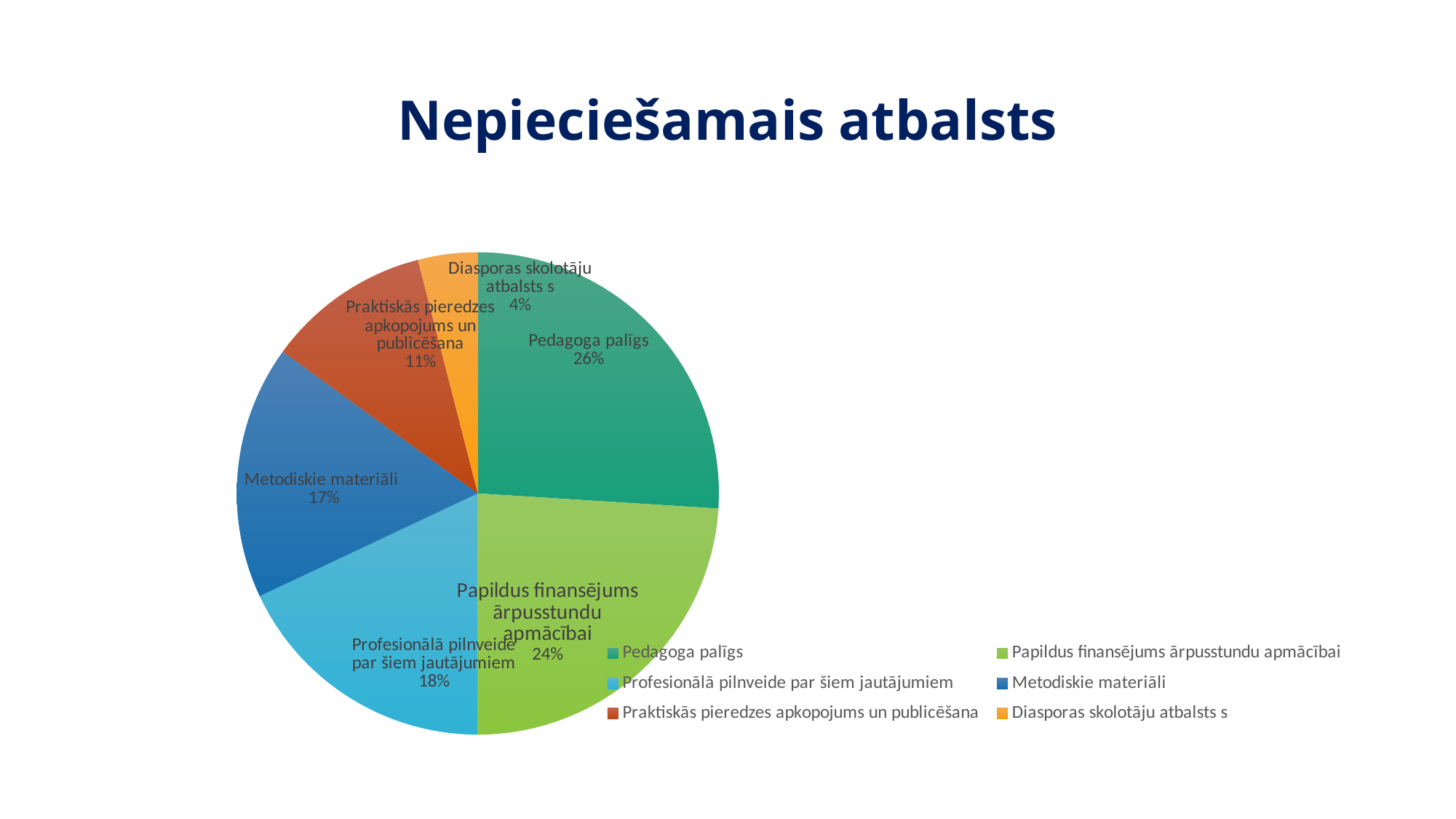
What share of the pie does "Metodiskie materiāli" have? 17% Which is larger: "Metodiskie materiāli" or "Praktiskās pieredzes apkopojums un publicēšana"? Metodiskie materiāli What colour is the slice for "Diasporas skolotāju atbalsts s"? orange What percentage is shown for "Profesionālā pilnveide par šiem jautājumiem"? 18% Which category has the largest slice of the pie? Pedagoga palīgs What is the title of the slide? Nepieciešamais atbalsts How many categories does the pie chart have? 6 What percentage is shown for "Diasporas skolotāju atbalsts s"? 4% What type of chart is shown on the slide? pie chart What is the difference in percentage points between "Pedagoga palīgs" and "Papildus finansējums ārpusstundu apmācībai"? 2 What share of the pie does "Pedagoga palīgs" have? 26% Which category has the smallest slice of the pie? Diasporas skolotāju atbalsts s